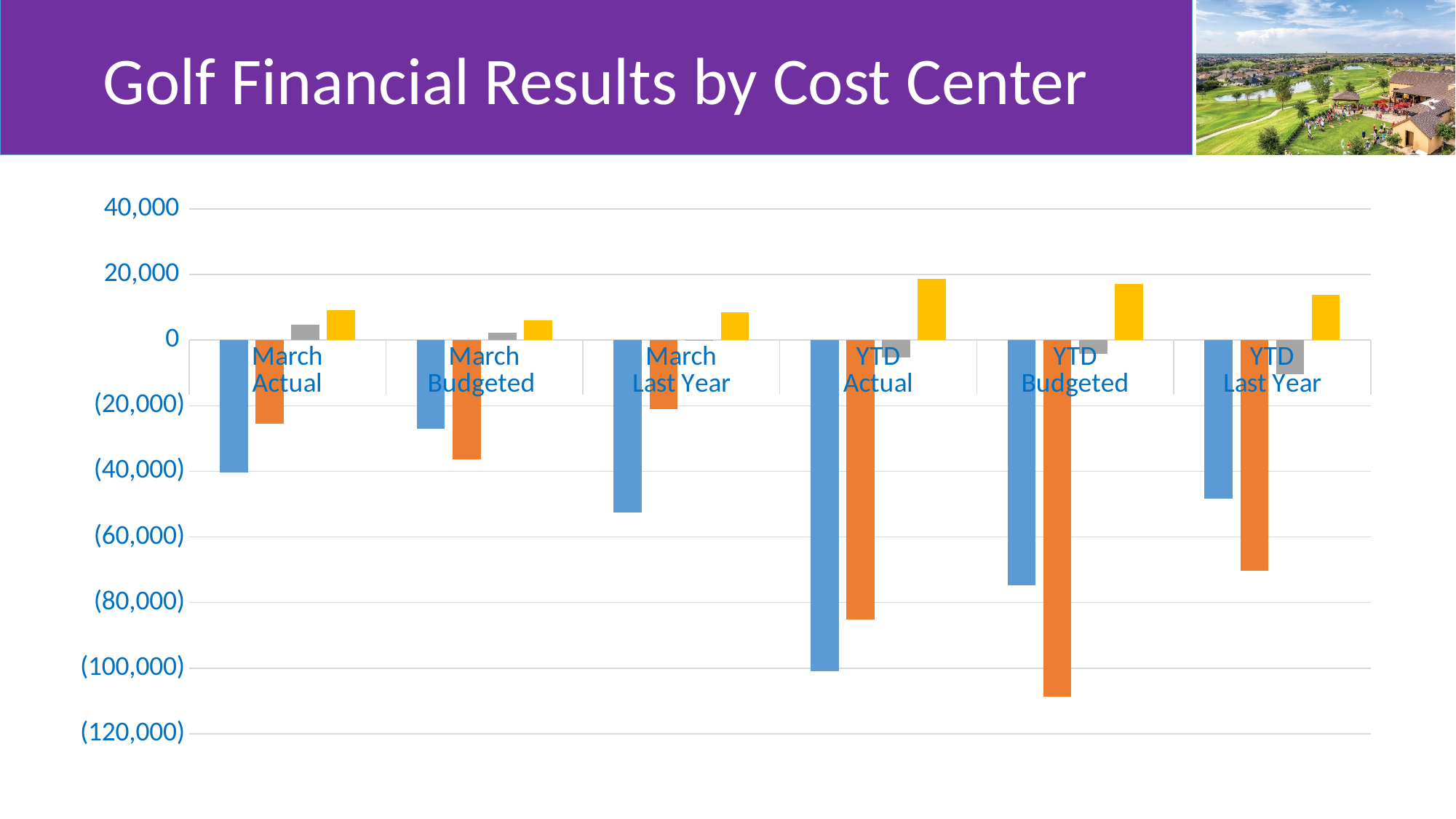
Is the value of the yellow bar for YTD Actual greater or less than 20,000? less Which category has the lowest blue bar? YTD Actual Is the value of the blue bar for March Budgeted greater or less than (40,000)? greater For March Actual, which is lower, the blue bar or the orange bar? the blue bar How many bars are plotted for each category? 4 What is the title of the slide containing the chart? Golf Financial Results by Cost Center Is the value of the orange bar for YTD Budgeted greater or less than (100,000)? less What kind of chart is shown on the slide? bar chart Which category has the lowest orange bar? YTD Budgeted How many categories are shown along the x axis? 6